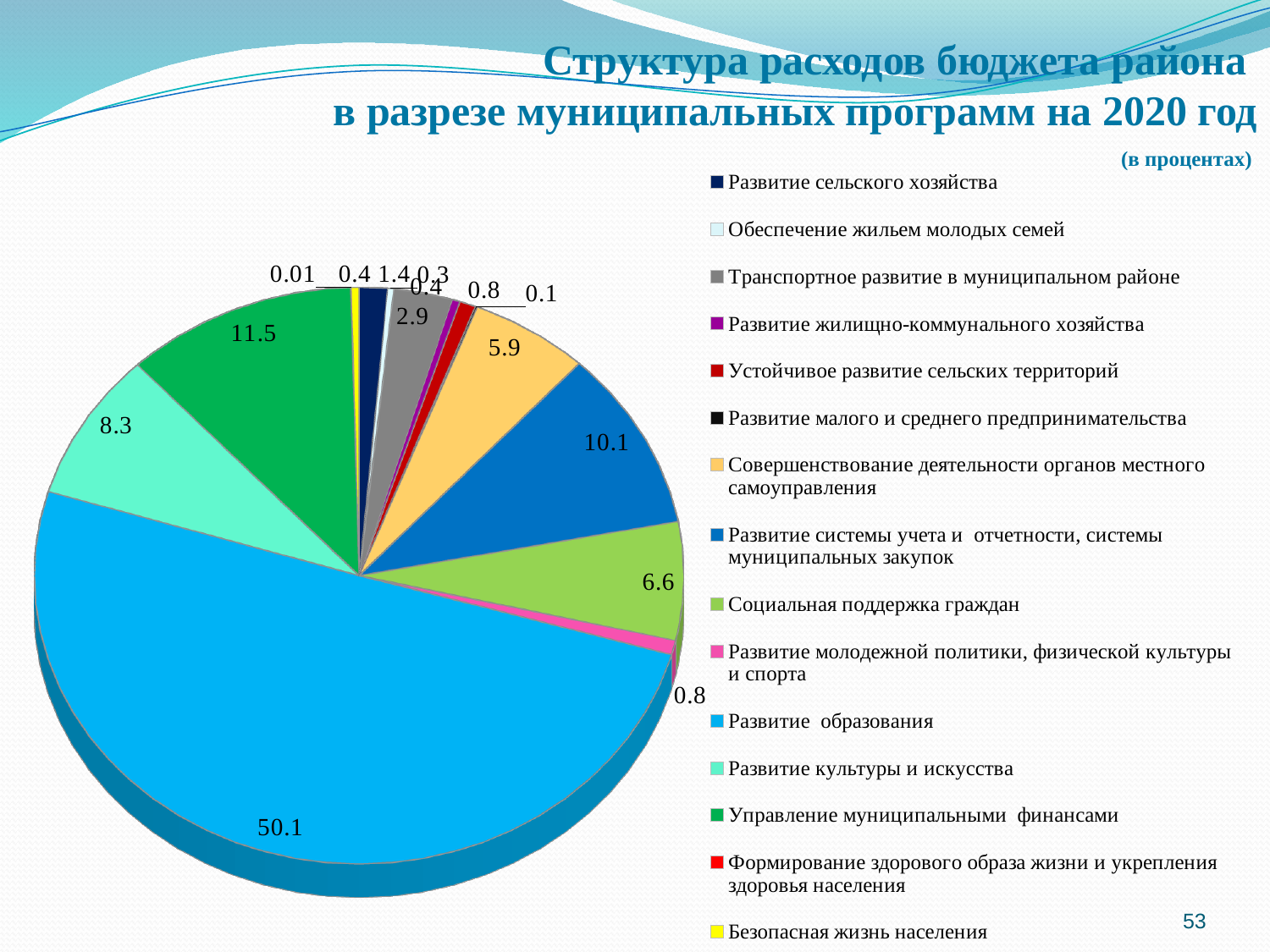
What is the value for Развитие образования? 50.1 What is the value for Социальная поддержка граждан? 6.6 How many programs are listed in the chart legend? 15 What is the value for Совершенствование деятельности органов местного самоуправления? 5.9 What kind of chart is shown on the slide? pie chart What is the value for Транспортное развитие в муниципальном районе? 2.9 Which is larger: Управление муниципальными финансами or Развитие системы учета и отчетности, системы муниципальных закупок? Управление муниципальными финансами What is the difference between the values for Развитие образования and Управление муниципальными финансами? 38.6 What is the value for Развитие системы учета и отчетности, системы муниципальных закупок? 10.1 Which program has the largest share of the district budget expenditures? Развитие образования What is the value for Развитие культуры и искусства? 8.3 What is the value for Управление муниципальными финансами? 11.5